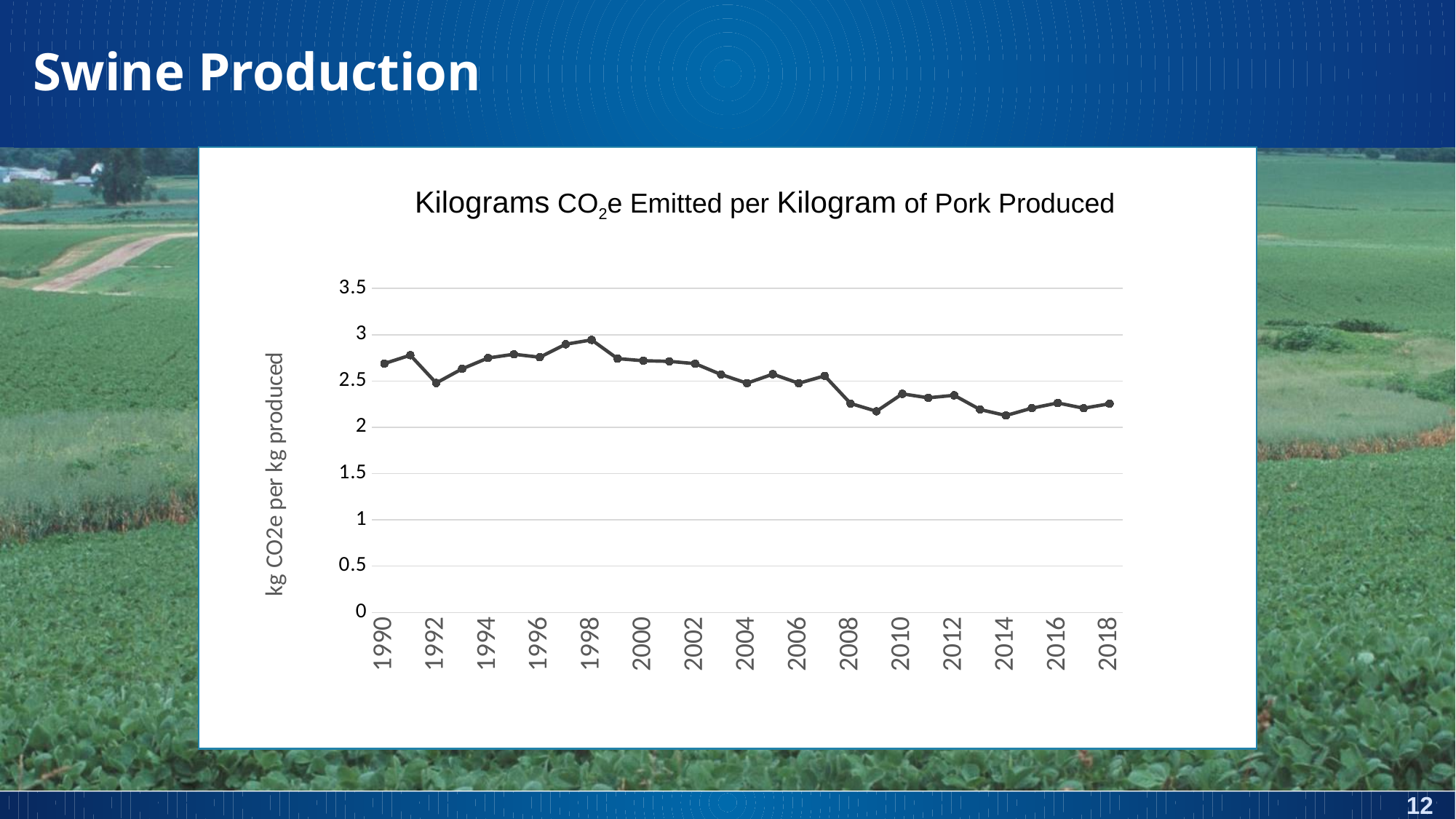
Is the value for 1990 greater or less than 2.5? greater How many data points are plotted on the line (years 1990 through 2018)? 29 Is the value for 1998 greater or less than 2.5? greater In which year is the value highest? 1998 What kind of chart is shown on the slide? line chart Which year has the larger value, 1990 or 2018? 1990 Is the value for 2014 greater or less than 2.5? less What is the title of the chart? Kilograms CO2e Emitted per Kilogram of Pork Produced What is the label on the vertical axis of the chart? kg CO2e per kg produced Overall, do the values rise or fall from 1990 to 2018? fall Which year has the larger value, 1998 or 2014? 1998